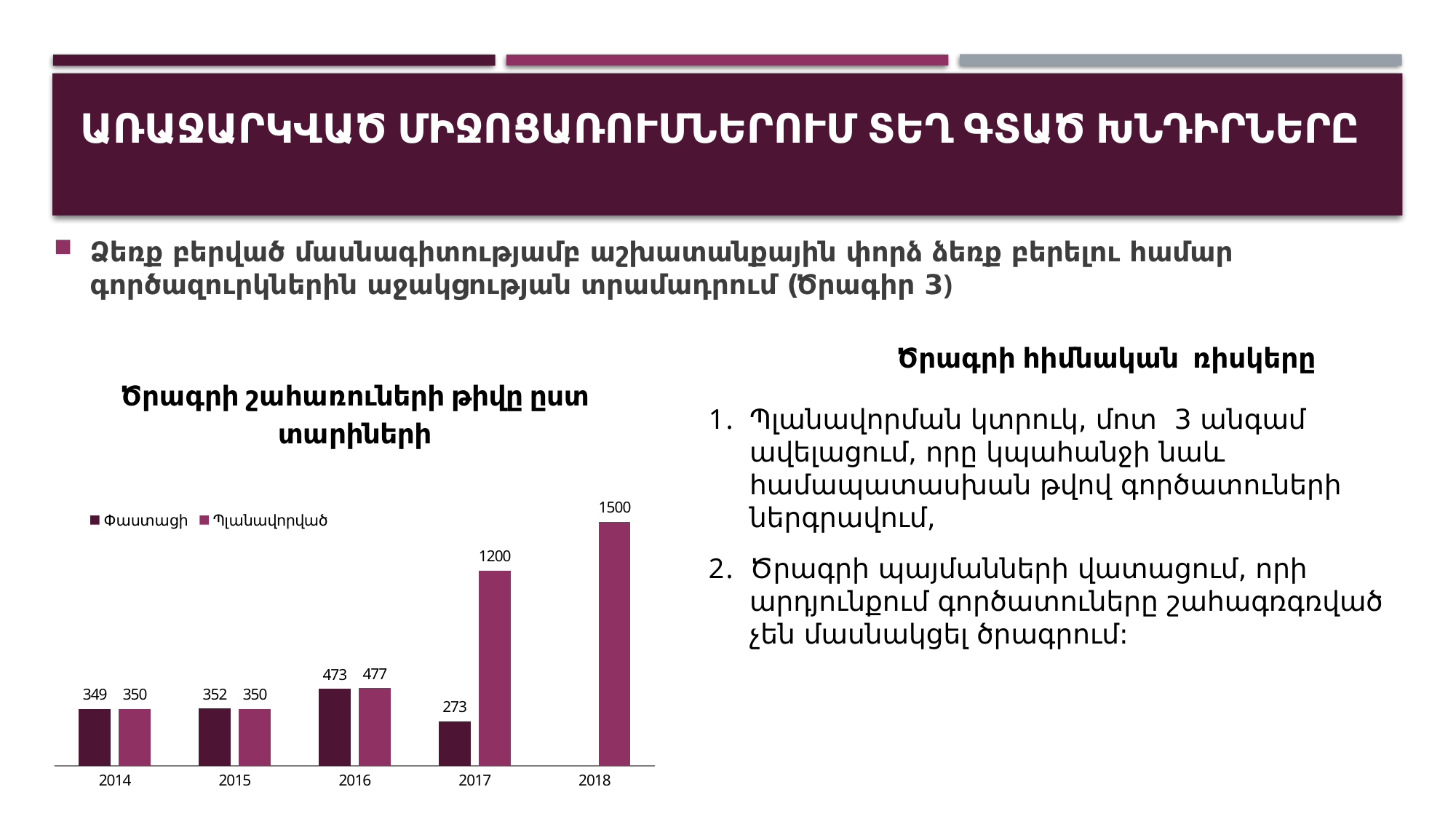
How many series does the chart legend list? 2 What is the Պլանավորված value for 2017? 1200 Which is larger for 2016, the Փաստացի value or the Պլանավորված value? Պլանավորված How many years are shown on the x axis of the chart? 5 Which year has the highest Պլանավորված value? 2018 What is the Փաստացի value for 2017? 273 What is the title of the chart? Ծրագրի շահառուների թիվը ըստ տարիների Which year has the lowest Փաստացի value? 2017 What is the Փաստացի value for 2016? 473 What kind of chart is shown on the slide? bar chart What is the Պլանավորված value for 2018? 1500 What is the difference between the Պլանավորված and Փաստացի values for 2017? 927